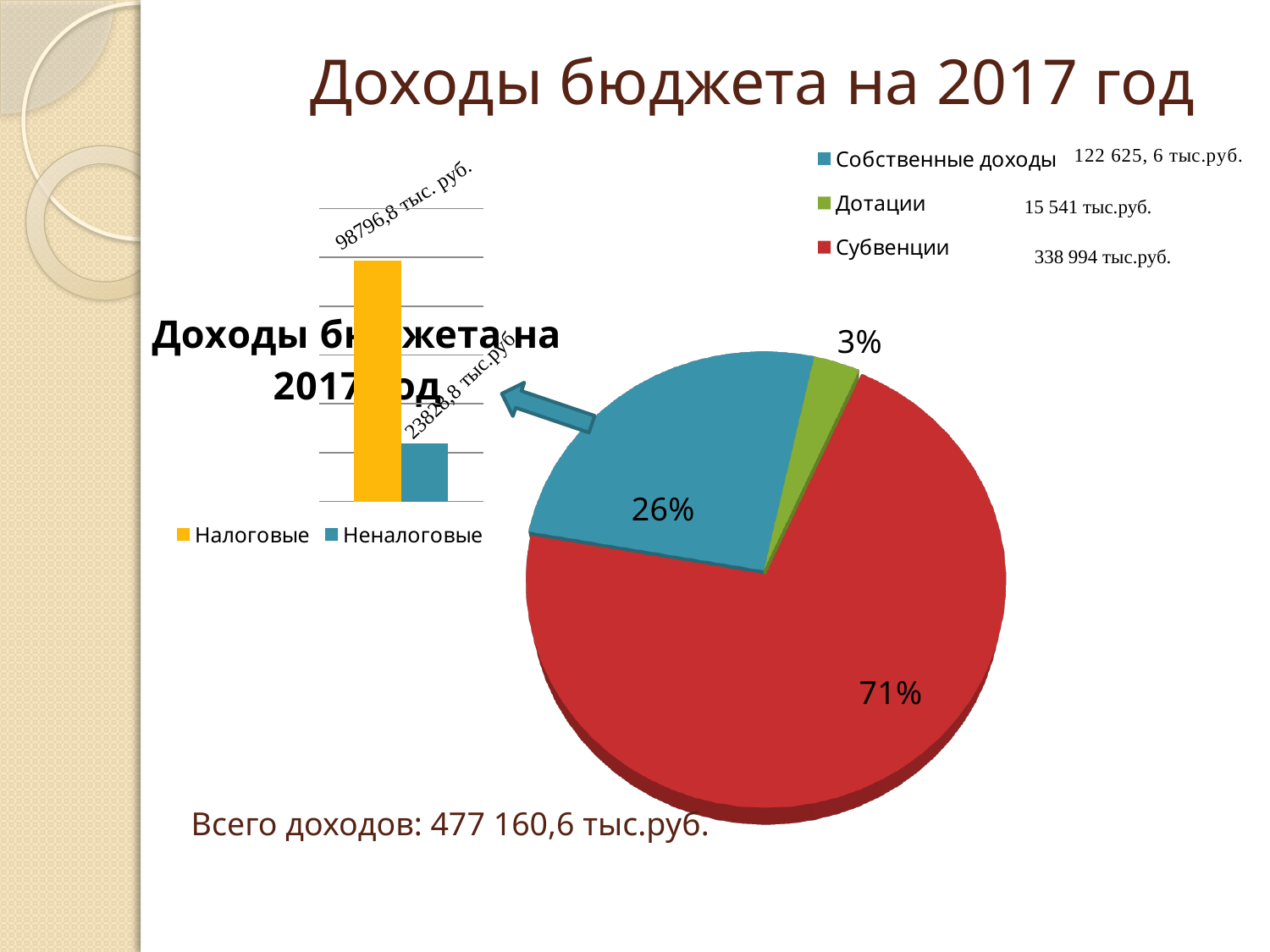
In the pie chart, what share does Собственные доходы have? 26% In the bar chart on the left, what colour is the Налоговые bar? yellow In the pie chart, which category has the largest slice? Субвенции What kind of chart is the large chart on the right of the slide? pie chart In the bar chart on the left, what is the value for Налоговые? 98796,8 тыс. руб. In the pie chart, what is the difference in percentage points between the Субвенции slice and the Собственные доходы slice? 45 In the pie chart, which category has the smallest slice? Дотации In the pie chart, what share does Дотации have? 3% What kind of chart is the small chart on the left of the slide? bar chart In the bar chart on the left, which is larger, Налоговые or Неналоговые? Налоговые In the pie chart, what share does Субвенции have? 71% How many series does the pie chart's legend list? 3